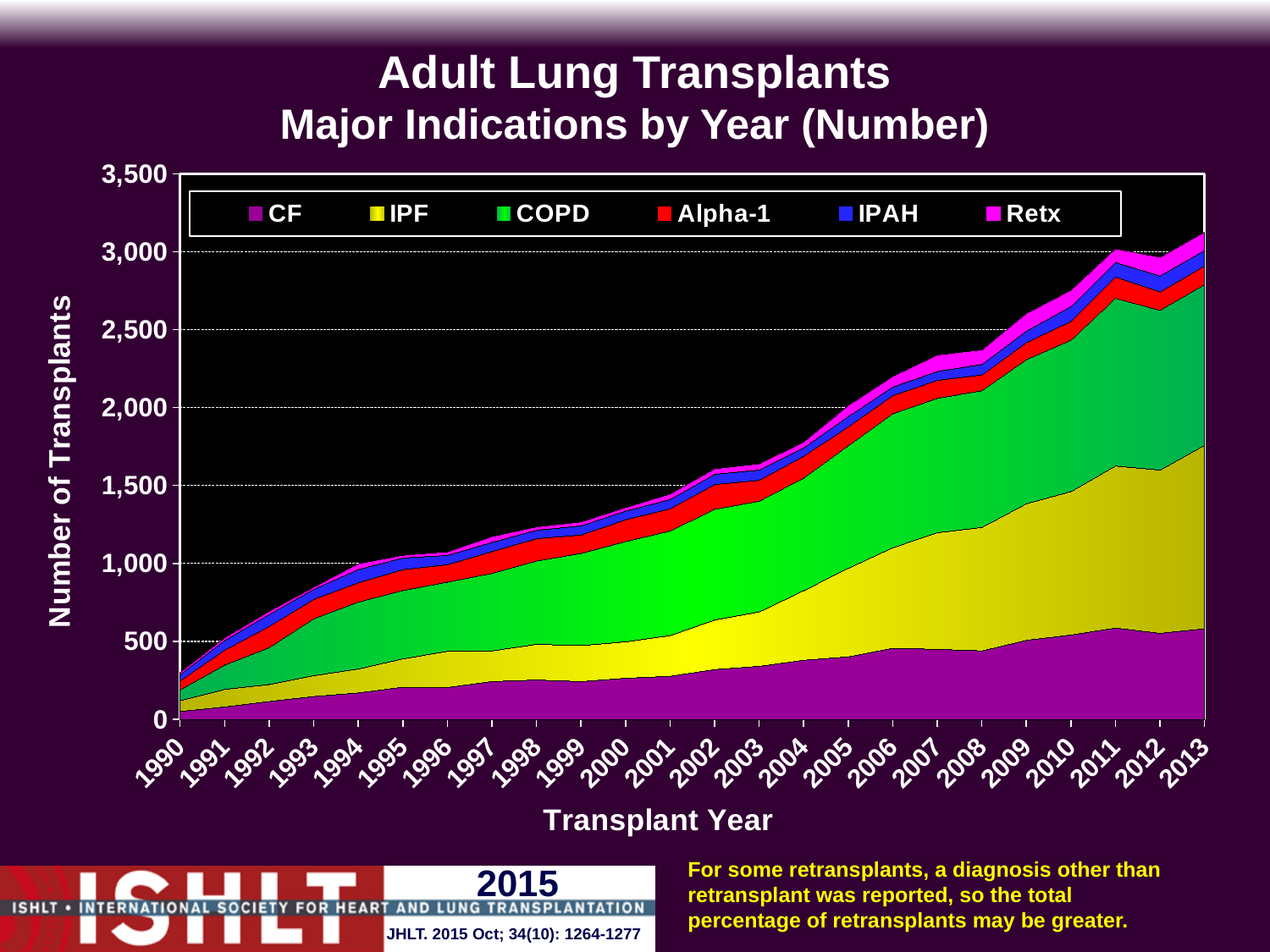
Does the total number of adult lung transplants rise or fall from 1990 to 2013? Rise Is the total number of transplants in 2000 greater or less than 1,000? greater Is the total number of transplants in 2011 greater or less than 2,500? greater What is the first year shown on the x axis? 1990 What kind of chart is shown on the slide? Stacked area chart What is the last year shown on the x axis? 2013 How many transplant years are shown along the x axis? 24 What is the title of the y axis? Number of Transplants How many series does the legend list? 6 Is the total number of transplants in 1990 greater or less than 500? less Which indication forms the bottom layer of the stacked area chart? CF